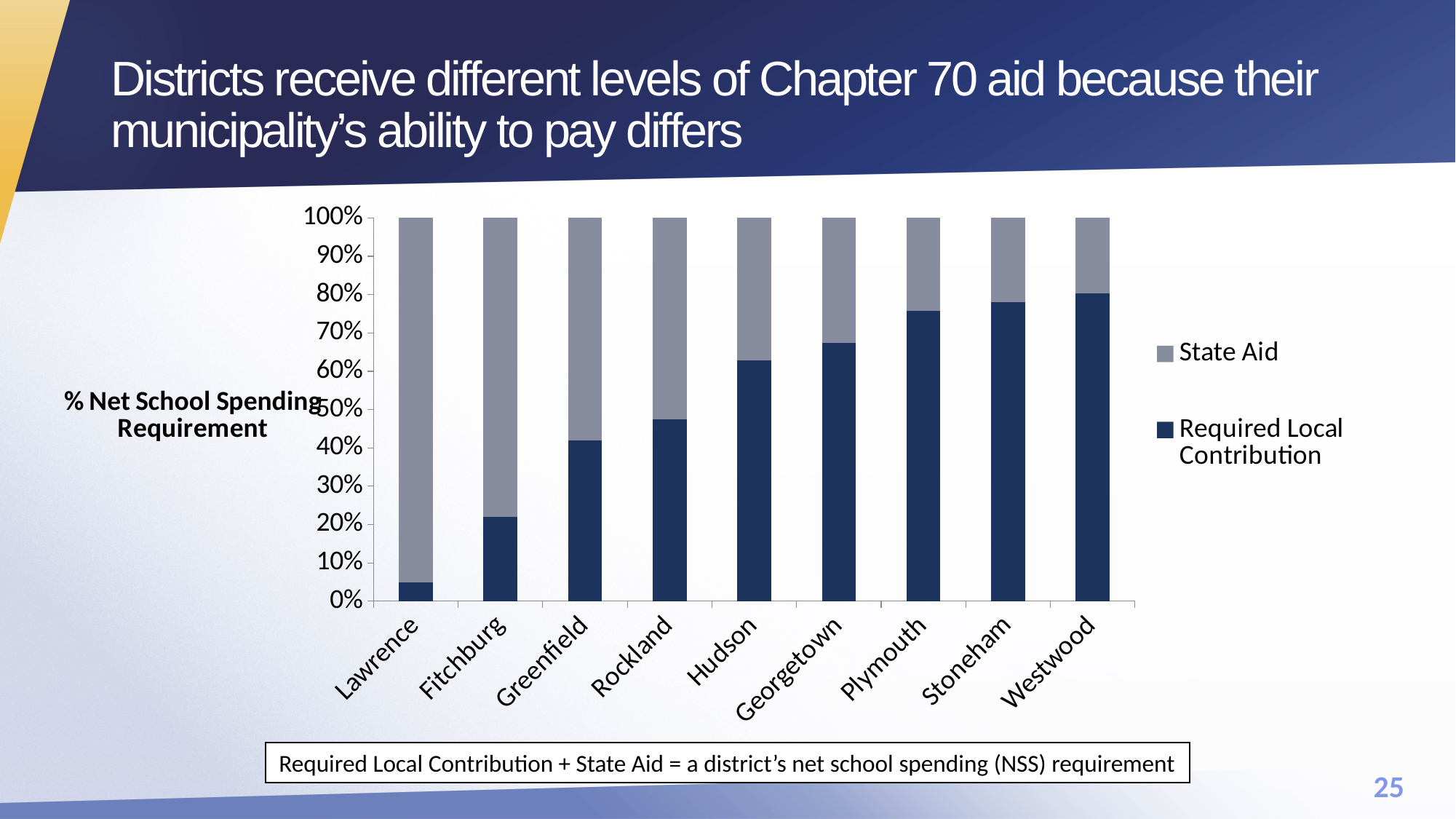
Which district has a larger Required Local Contribution share, Greenfield or Hudson? Hudson Which district receives the largest State Aid share of its net school spending requirement? Lawrence Which district has the lowest Required Local Contribution share? Lawrence Is the Required Local Contribution for Lawrence greater or less than 10%? less Does the Required Local Contribution share rise or fall moving from Lawrence to Westwood along the x axis? Rise Is the Required Local Contribution for Hudson greater or less than 60%? greater Is the Required Local Contribution for Plymouth greater or less than 70%? greater What kind of chart is shown on the slide? Stacked bar chart How many series does the chart's legend list? 2 How many districts are shown on the x axis of the chart? 9 Which district has the highest Required Local Contribution share? Westwood